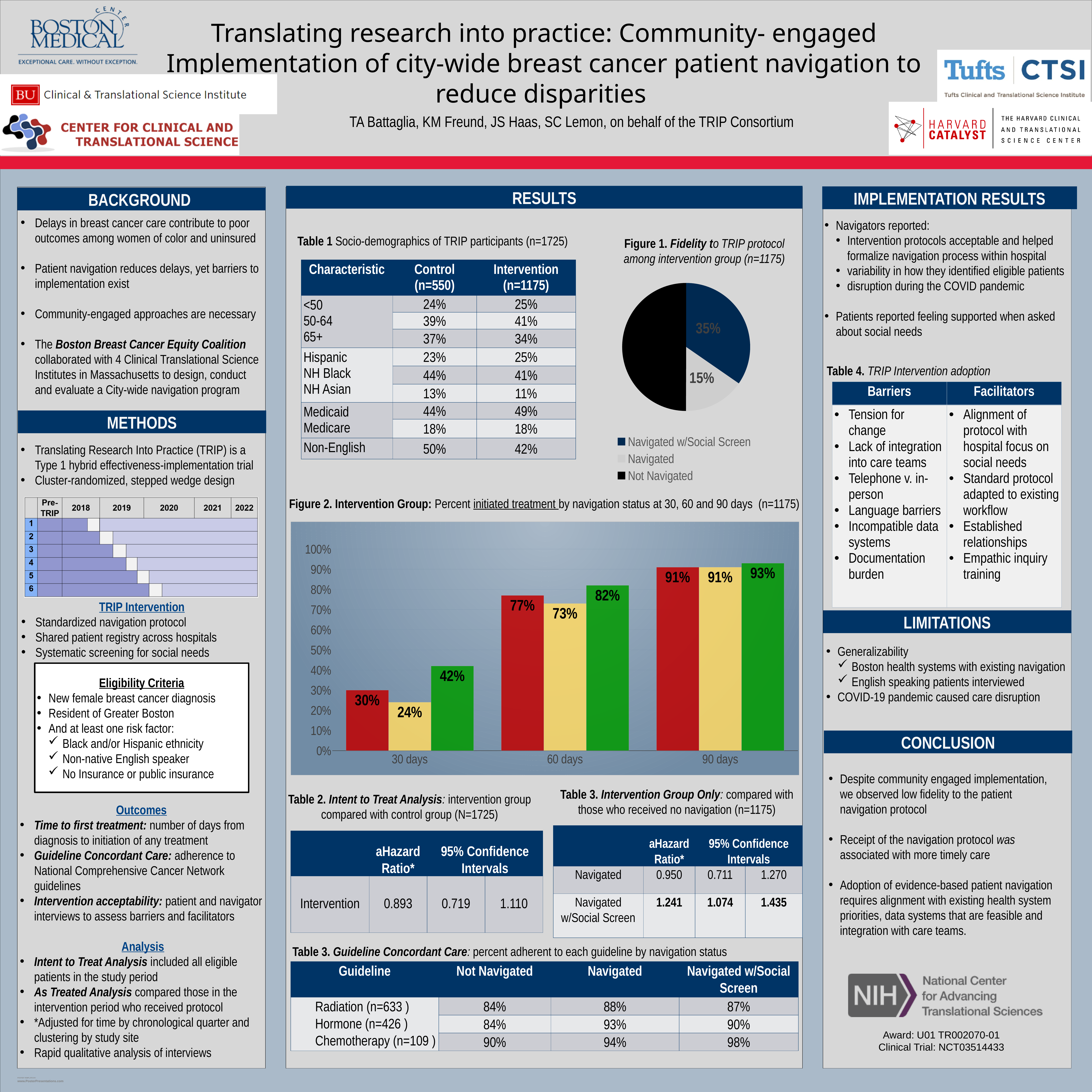
In Figure 2 (Percent initiated treatment), what value is labeled on the green bar at 90 days? 93% In Figure 1 (Fidelity to TRIP protocol), what percentage is shown for the Navigated w/Social Screen slice? 35% What kind of chart is Figure 2 (Intervention Group: Percent initiated treatment)? Bar chart In Figure 2 (Percent initiated treatment), how many time-point groups are shown on the x axis? 3 In Figure 1 (Fidelity to TRIP protocol), which legend category has the largest slice? Not Navigated In Figure 2 (Percent initiated treatment), what is the difference between the green bar (42%) and the yellow bar (24%) at 30 days? 18 percentage points In Figure 2 (Percent initiated treatment), do the green bar values rise or fall from 30 days to 90 days? Rise What kind of chart is Figure 1 (Fidelity to TRIP protocol)? Pie chart How many categories does the legend of Figure 1 (Fidelity to TRIP protocol) list? 3 In Figure 1 (Fidelity to TRIP protocol), what percentage is shown for the Navigated slice? 15% In Figure 2 (Percent initiated treatment), what value is labeled on the yellow bar at 60 days? 73% In Figure 2 (Percent initiated treatment), what value is labeled on the red bar at 30 days? 30%